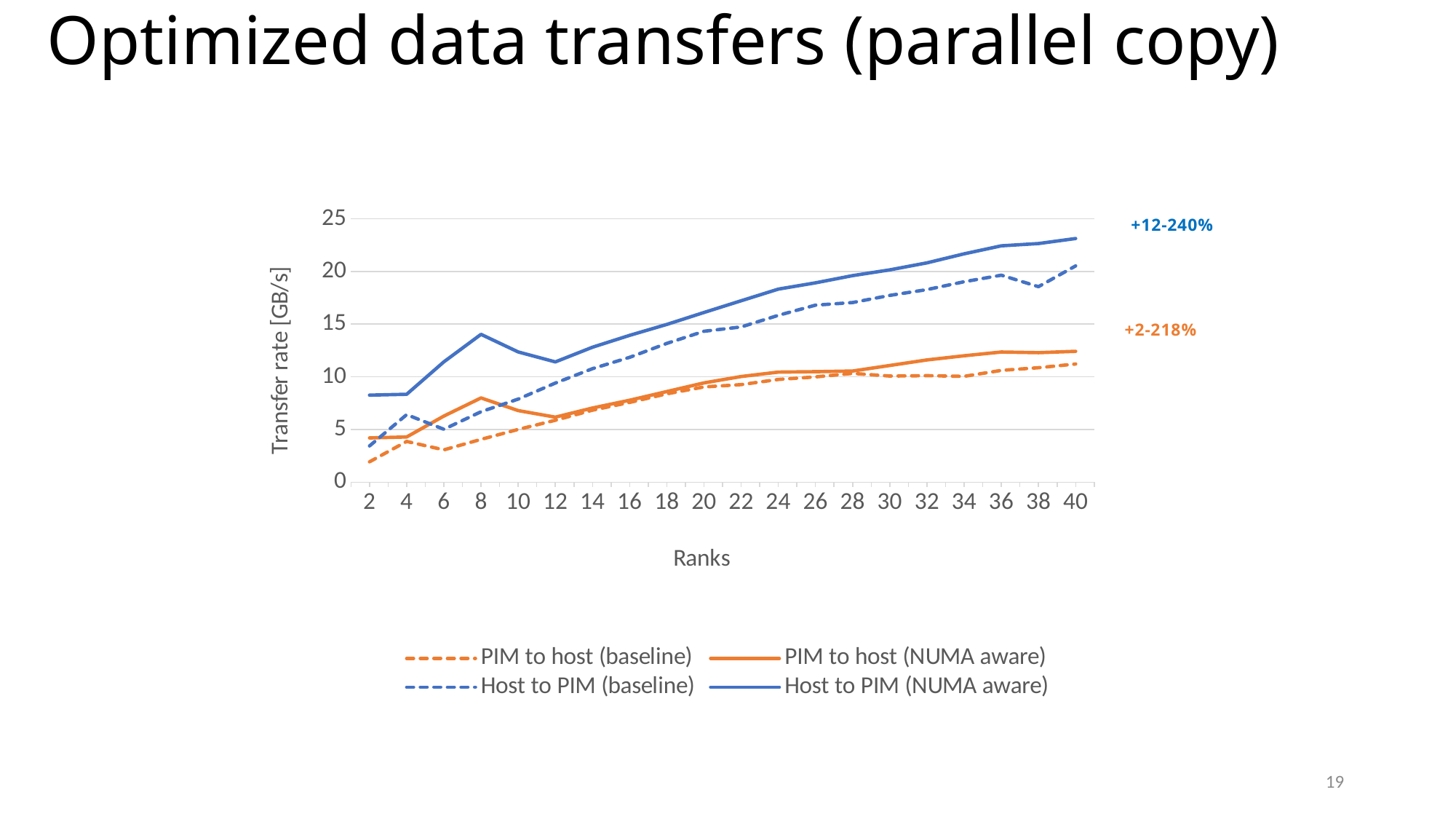
Is the value for PIM to host (NUMA aware) at 40 ranks greater or less than 10? greater At 8 ranks, which is larger: Host to PIM (NUMA aware) or Host to PIM (baseline)? Host to PIM (NUMA aware) Is the value for PIM to host (baseline) at 2 ranks greater or less than 5? less Which series has the lowest transfer rate at 2 ranks? PIM to host (baseline) Is the value for Host to PIM (NUMA aware) at 24 ranks greater or less than 15? greater How many series does the legend list? 4 Does the Host to PIM (NUMA aware) transfer rate generally rise or fall as the number of ranks increases? Rise What kind of chart is shown on the slide? Line chart What is the label of the y axis? Transfer rate [GB/s] Which series has the highest transfer rate at 40 ranks? Host to PIM (NUMA aware) How many rank values are marked along the x axis? 20